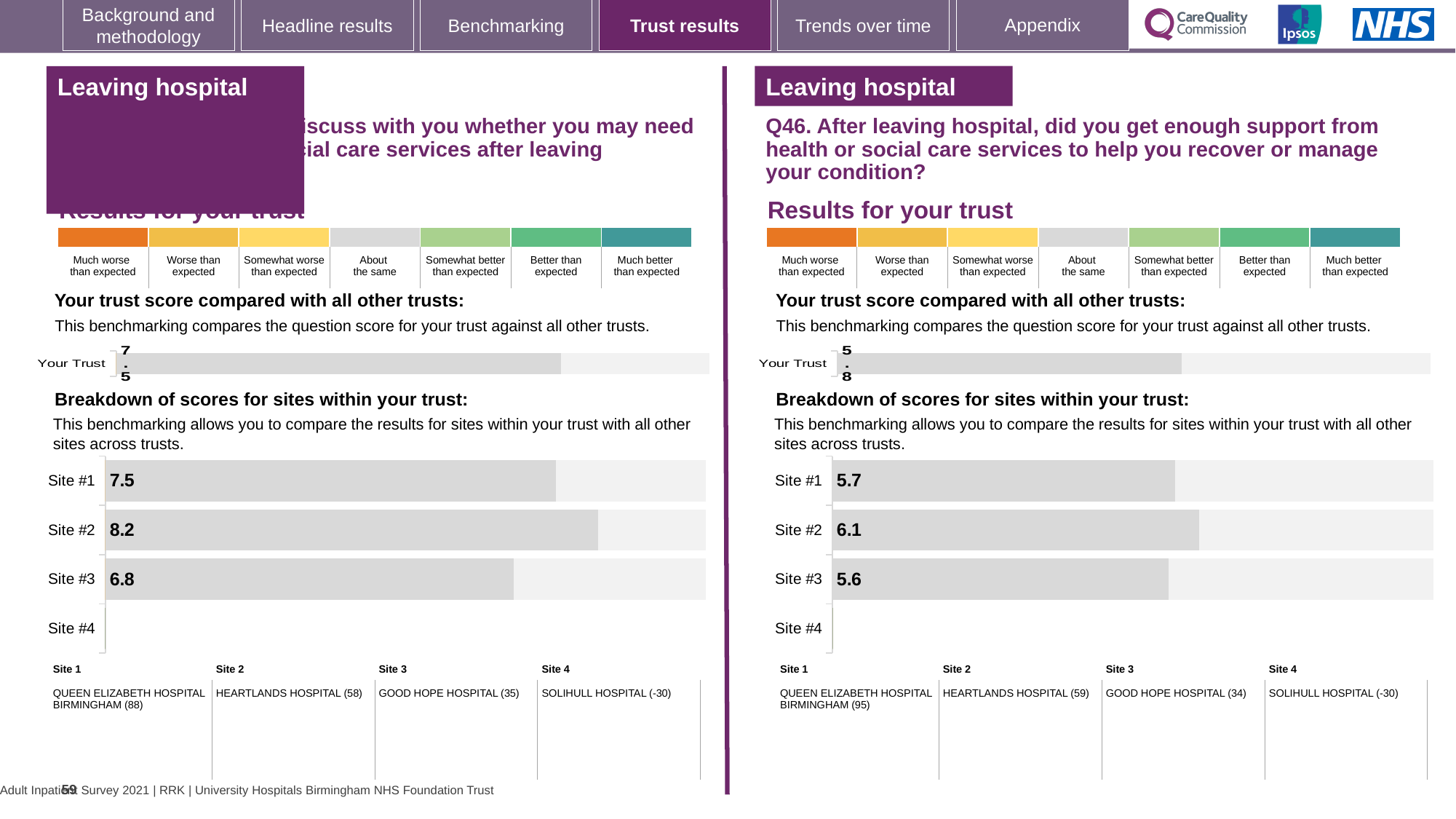
In the left-hand 'Your trust score compared with all other trusts' chart, what is the score for Your Trust? 7.5 In the right-hand (Q46) 'Your trust score compared with all other trusts' chart, what is the score for Your Trust? 5.8 What kind of chart is the right-hand (Q46) 'Breakdown of scores for sites within your trust' chart? Bar chart In the right-hand (Q46) 'Breakdown of scores for sites within your trust' chart, what is the score for Site #1? 5.7 In the left-hand 'Breakdown of scores for sites within your trust' chart, what is the score for Site #2? 8.2 In the right-hand (Q46) 'Breakdown of scores for sites within your trust' chart, is the score for Site #2 or Site #3 larger? Site #2 In the left-hand 'Breakdown of scores for sites within your trust' chart, what is the difference between the scores for Site #2 and Site #3? 1.4 In the right-hand (Q46) 'Breakdown of scores for sites within your trust' chart, what is the difference between the scores for Site #2 and Site #1? 0.4 In the right-hand (Q46) 'Breakdown of scores for sites within your trust' chart, which site has the highest score? Site #2 In the left-hand 'Breakdown of scores for sites within your trust' chart, is the score for Site #1 or Site #3 larger? Site #1 In the left-hand 'Breakdown of scores for sites within your trust' chart, which site has the lowest score shown? Site #3 How many site categories are listed on the axis of the left-hand 'Breakdown of scores for sites within your trust' chart? 4